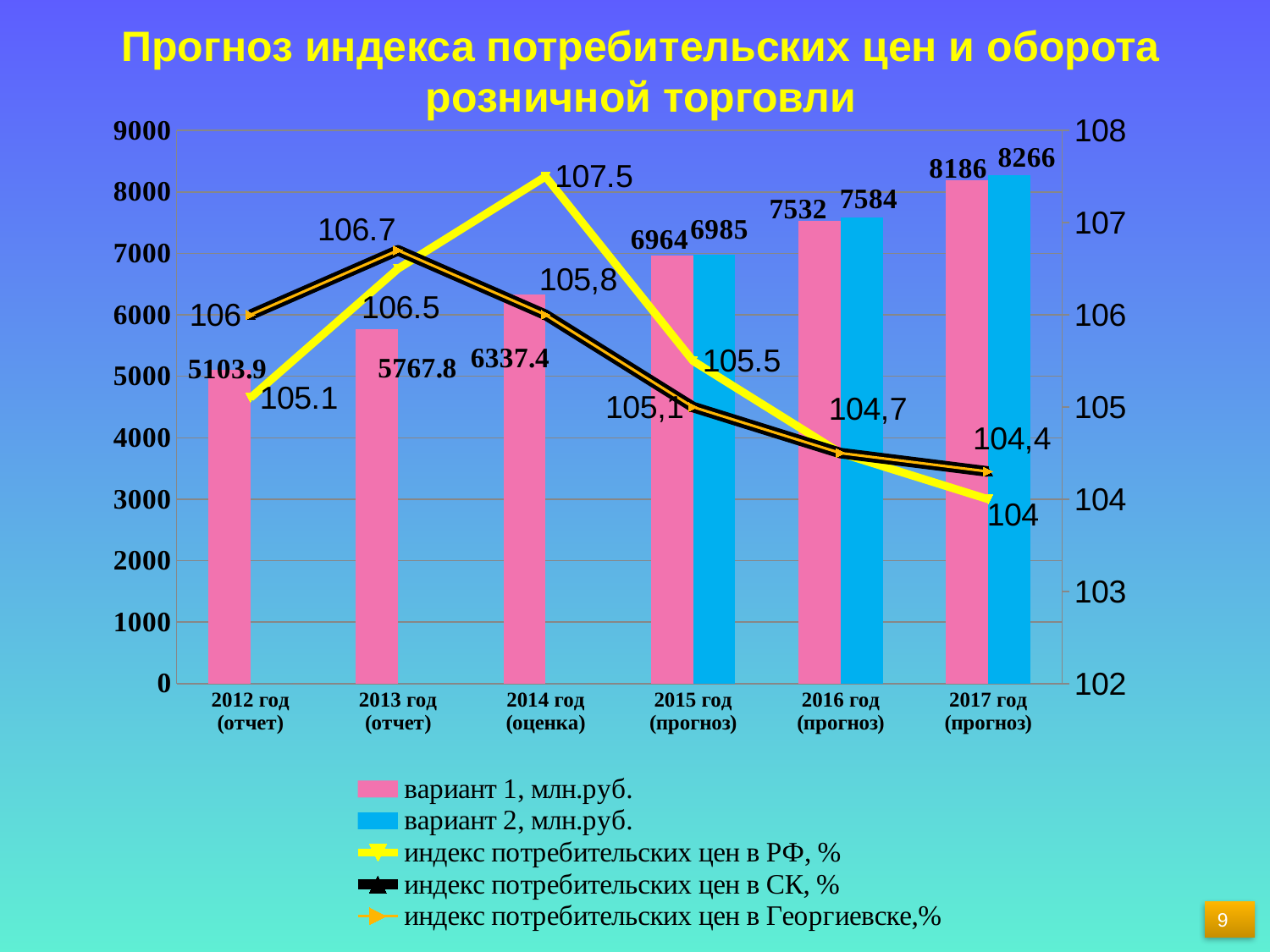
What is the value of вариант 2, млн.руб. for 2017 год (прогноз)? 8266 How many year categories are shown on the x axis? 6 Do the values of вариант 1, млн.руб. rise or fall from 2012 to 2017? Rise In which year does the yellow line (индекс потребительских цен в РФ, %) reach its highest value? 2014 год (оценка) In which year is вариант 1, млн.руб. the lowest? 2012 год (отчет) In 2016 год (прогноз), which is larger: вариант 1 or вариант 2? вариант 2 What is the difference between вариант 2 and вариант 1 in 2015 год (прогноз)? 21 What kind of chart is shown on the slide? Combination bar and line chart What is the value of вариант 1, млн.руб. for 2012 год (отчет)? 5103.9 What is the difference between вариант 1 in 2017 год (прогноз) and вариант 1 in 2016 год (прогноз)? 654 How many series does the legend list? 5 What is the value of вариант 1, млн.руб. for 2016 год (прогноз)? 7532